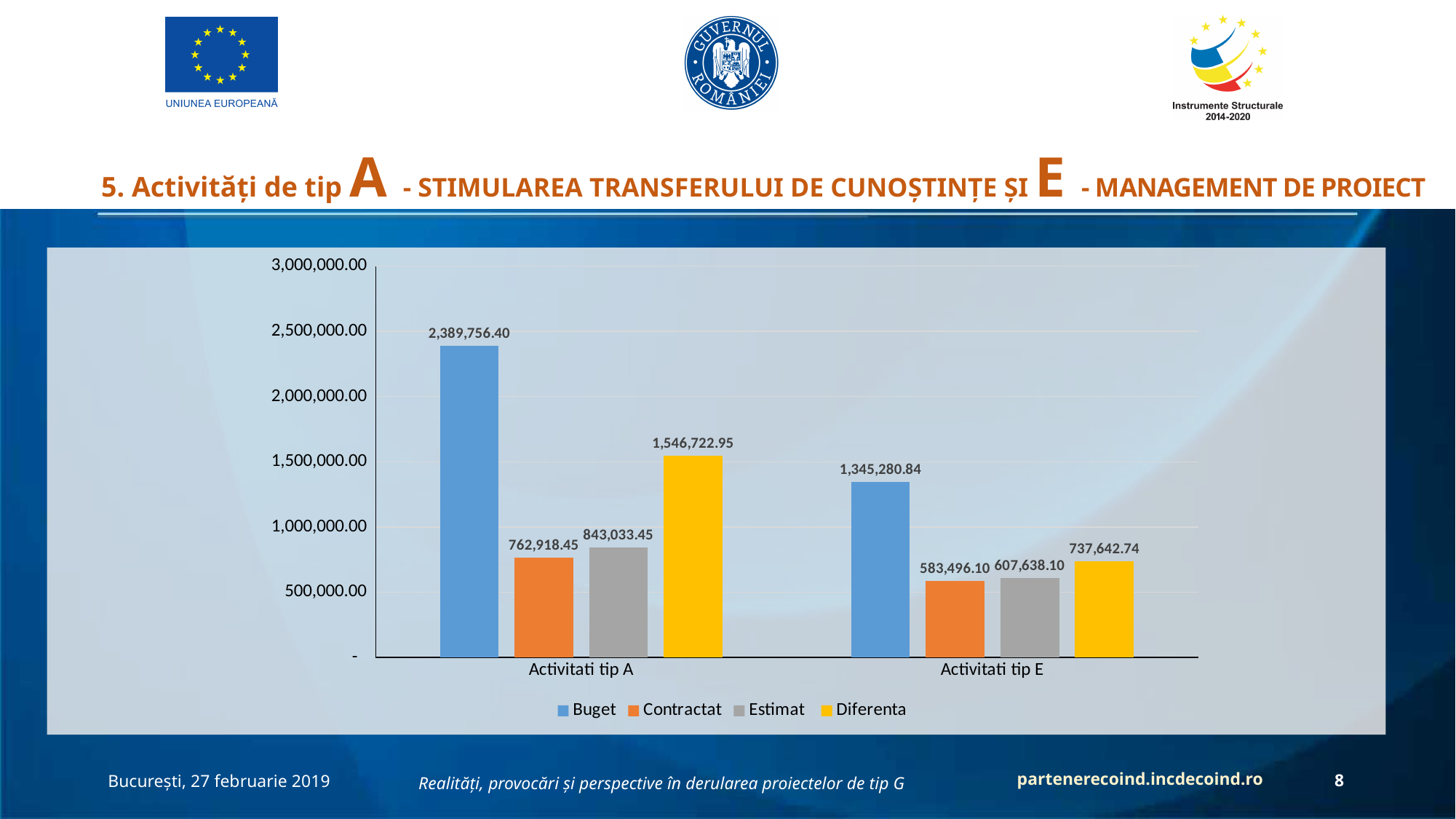
What is the Estimat value for Activitati tip A? 843,033.45 How many categories are shown on the x axis? 2 Which is larger: the Diferenta value for Activitati tip A or the Buget value for Activitati tip E? Diferenta for Activitati tip A What is the Diferenta value for Activitati tip E? 737,642.74 Which legend entry is shown in yellow? Diferenta What is the Contractat value for Activitati tip E? 583,496.10 Which series has the highest value for Activitati tip A? Buget What type of chart is shown on the slide? bar chart Which series has the lowest value for Activitati tip E? Contractat How many series does the legend list? 4 What is the difference between the Buget values for Activitati tip A and Activitati tip E? 1,044,475.56 What is the Buget value for Activitati tip A? 2,389,756.40